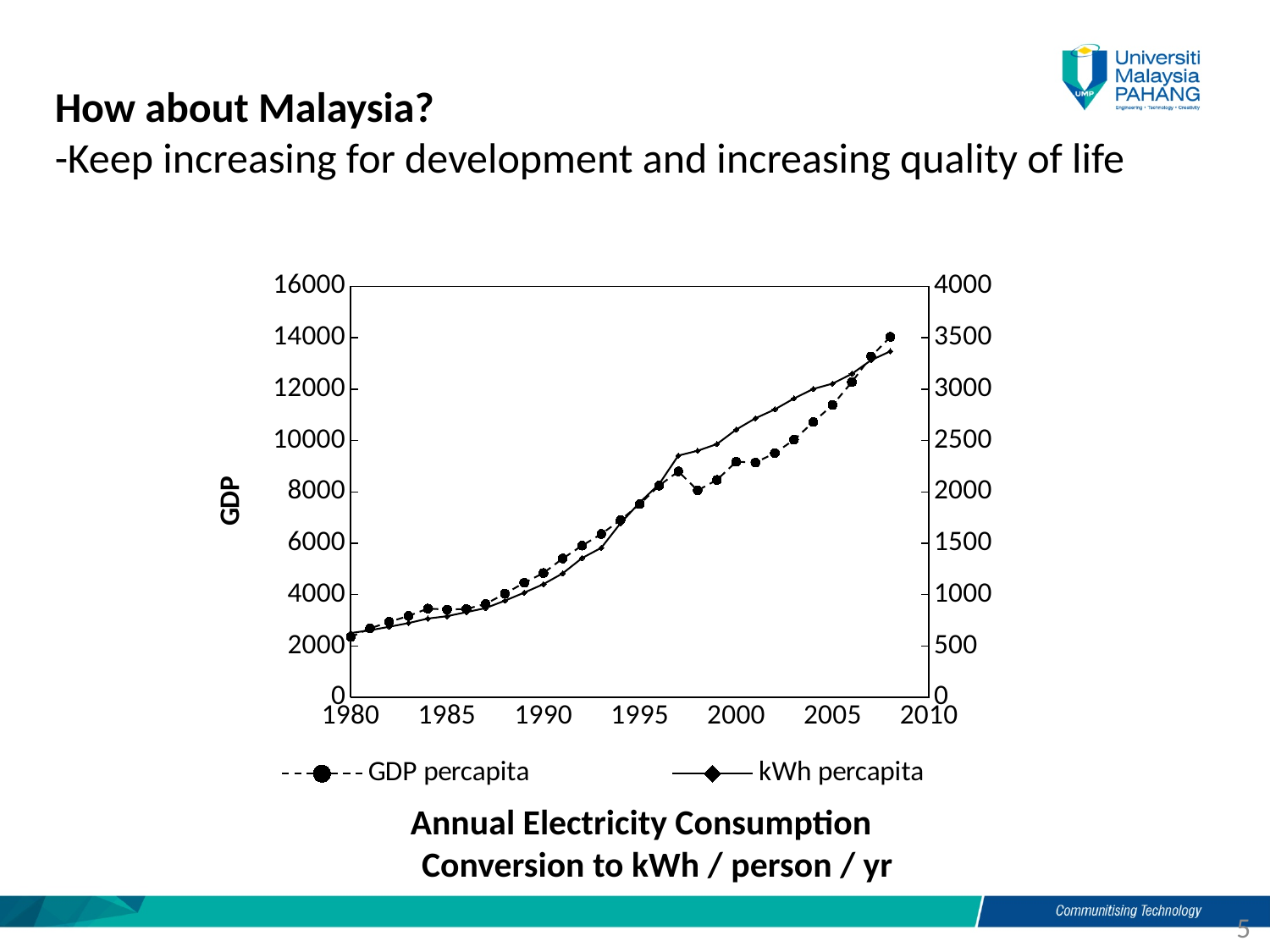
Is the GDP percapita value in 2008 greater or less than 12000 on the left axis? greater Is the kWh percapita value in 2008 greater or less than 3000 on the right axis? greater Is the GDP percapita value in 1990 greater or less than 4000 on the left axis? greater Does the GDP percapita series generally rise or fall from 1980 to 2008? rise How many series does the legend list? 2 Which two series are listed in the legend? GDP percapita and kWh percapita What kind of chart is shown on the slide? line chart Does the kWh percapita series generally rise or fall from 1980 to 2008? rise What is the title of the left vertical axis? GDP